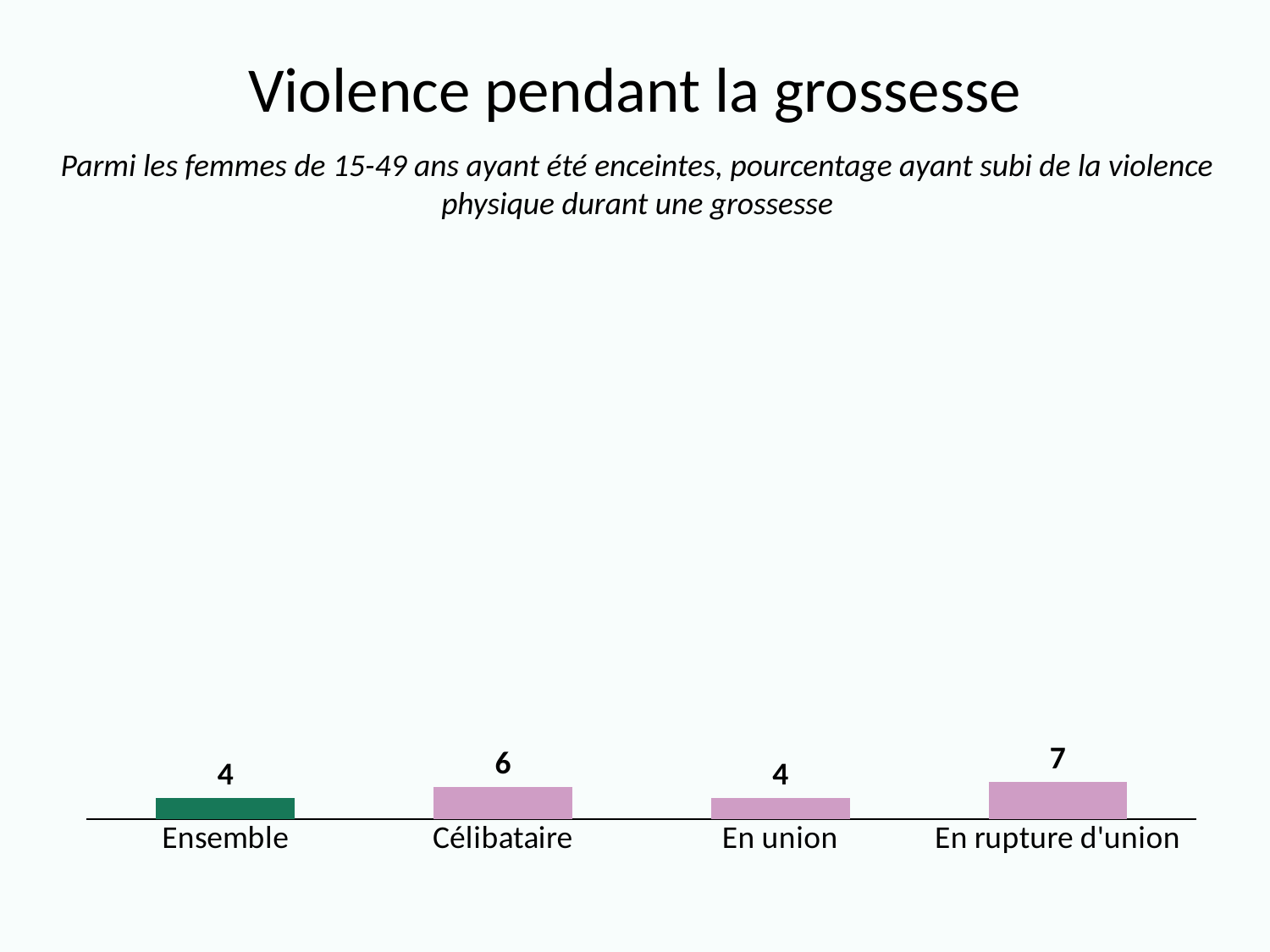
What is the difference between the values for En rupture d'union and Célibataire? 1 What kind of chart is shown on the slide? Bar chart Which category has the highest value? En rupture d'union What is the value for En union? 4 What is the difference between the values for Célibataire and En union? 2 Which bar is coloured differently from the others? Ensemble What is the title of the chart? Violence pendant la grossesse What is the value for Célibataire? 6 How many categories are shown on the x axis? 4 What is the value for En rupture d'union? 7 Which is larger, the value for Célibataire or the value for En union? Célibataire What is the value for Ensemble? 4